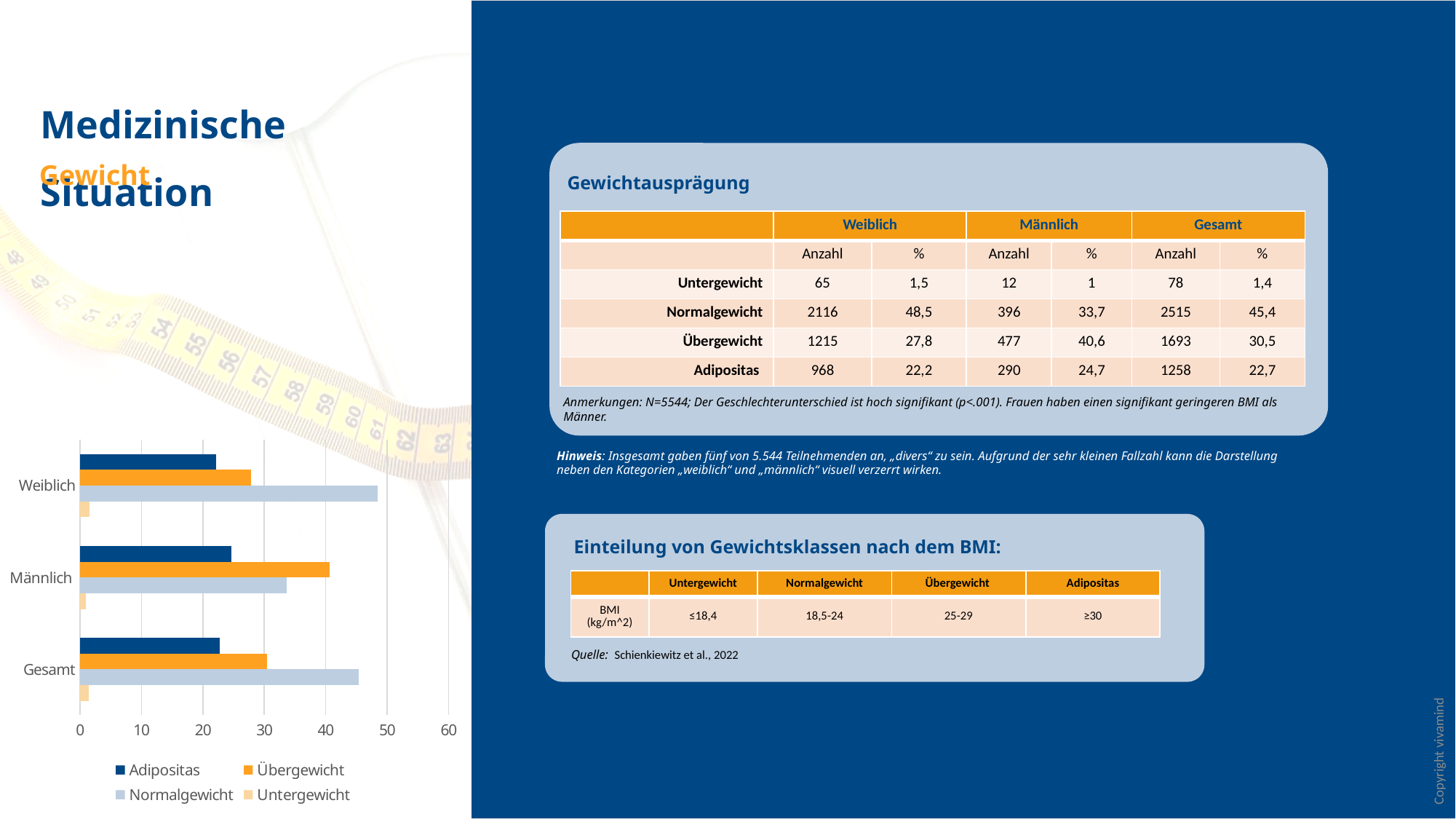
In the bar chart, which series has the longest bar for Männlich? Übergewicht What kind of chart is shown on the left of the slide? bar chart In the bar chart, which series has the shortest bar for Gesamt? Untergewicht In the bar chart, is the Normalgewicht value for Weiblich greater or less than 40? greater In the bar chart, is the Adipositas value for Weiblich greater or less than 30? less How many categories are shown on the vertical axis of the bar chart? 3 In the bar chart, is the Untergewicht value for Gesamt greater or less than 10? less In the bar chart, is the Übergewicht bar longer for Weiblich or for Männlich? Männlich In the bar chart, is the Normalgewicht bar longer for Weiblich or for Männlich? Weiblich How many series does the legend of the bar chart list? 4 What is the highest value shown on the horizontal axis of the bar chart? 60